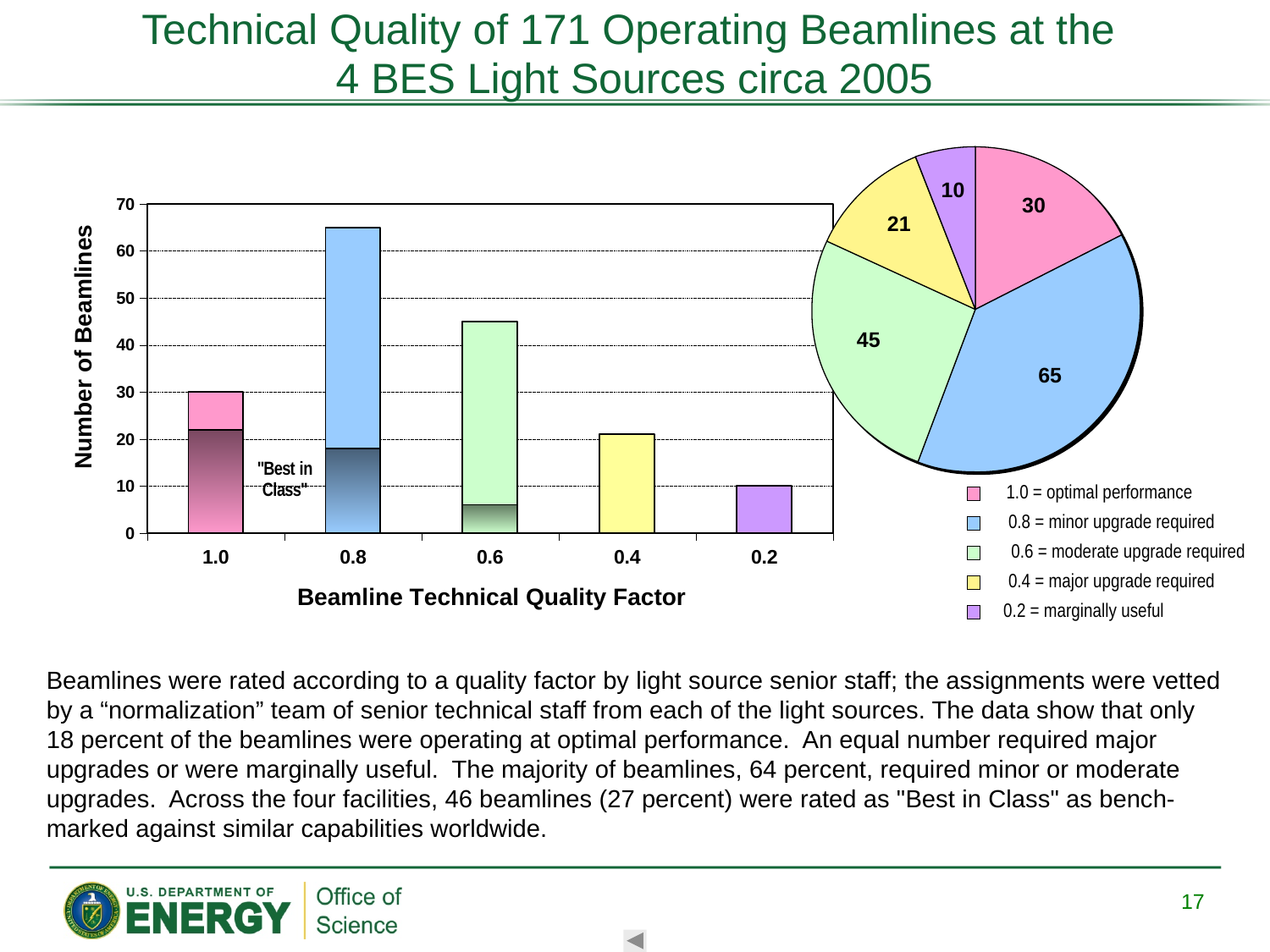
In the pie chart, what is the value of the slice for 0.8 = minor upgrade required? 65 In the pie chart, which is larger, the slice for 1.0 = optimal performance or the slice for 0.4 = major upgrade required? 1.0 = optimal performance In the pie chart, which category has the largest slice? 0.8 = minor upgrade required What is the label of the y axis of the bar chart? Number of Beamlines How many entries does the legend of the pie chart list? 5 What kind of chart is the chart on the left of the slide? bar chart In the pie chart, which category has the smallest slice? 0.2 = marginally useful In the bar chart, is the number of beamlines for quality factor 0.8 greater or less than 60? greater In the pie chart, what is the difference between the 0.8 slice and the 0.6 slice? 20 In the bar chart, how many categories are shown on the Beamline Technical Quality Factor axis? 5 In the bar chart, what is the number of beamlines for quality factor 1.0? 30 In the pie chart, what is the value of the slice for 0.4 = major upgrade required? 21